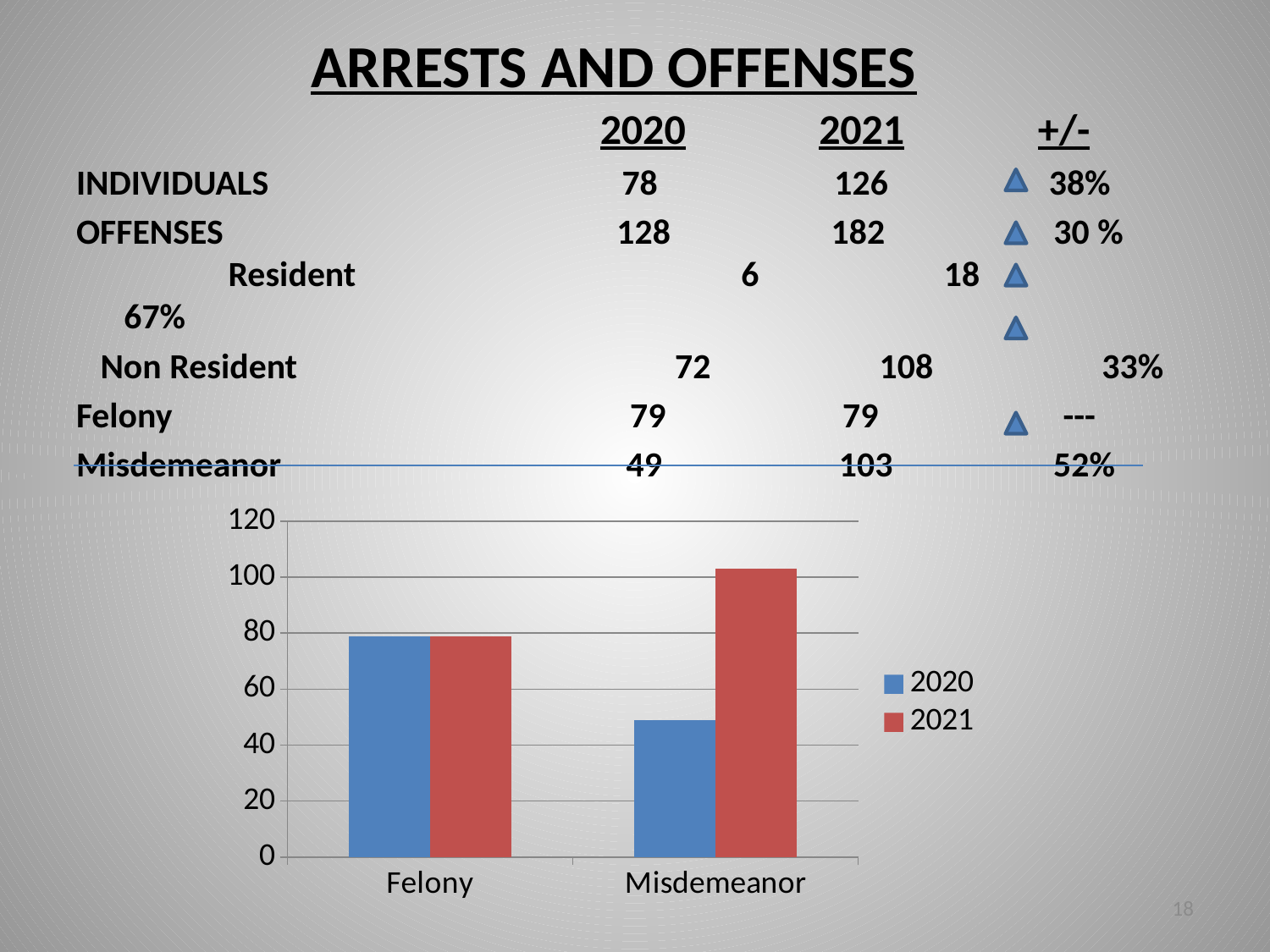
Which colour represents the 2021 series in the chart? red Is the value for Misdemeanor in 2020 greater or less than 60? less What is the difference between the 2021 and 2020 values for Misdemeanor? 54 What is the value for Misdemeanor in 2020? 49 How many series does the chart's legend list? 2 Is the value for Felony in 2021 greater or less than 100? less Is the value for Misdemeanor in 2021 greater or less than 100? greater For Misdemeanor, which year has the larger value, 2020 or 2021? 2021 What is the value for Misdemeanor in 2021? 103 What is the value for Felony in 2020? 79 How many categories are shown on the x axis of the chart? 2 What kind of chart is shown on the slide? bar chart